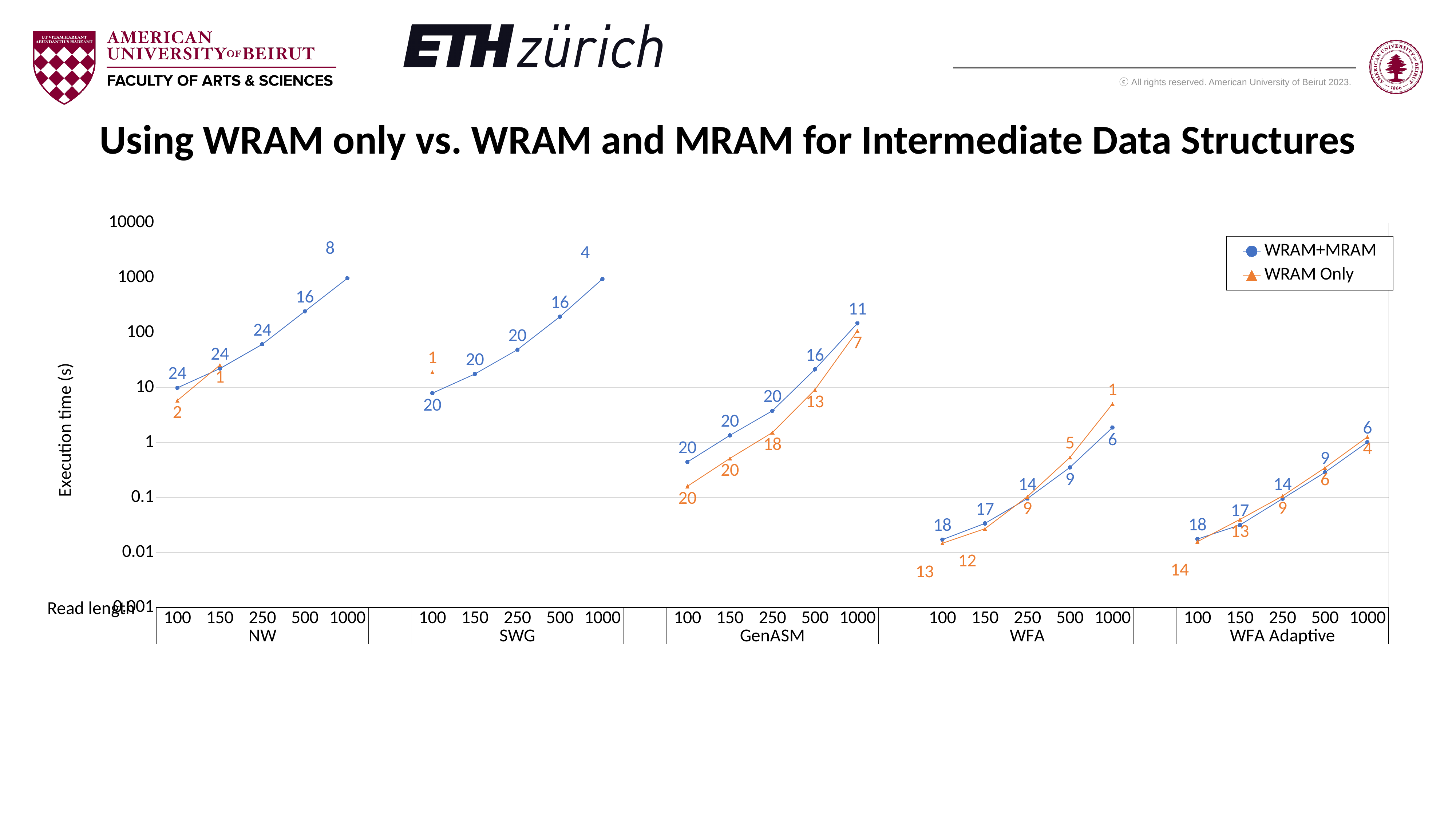
How many algorithm groups are shown along the x axis? 5 What is the label of the y axis? Execution time (s) Is the WRAM+MRAM execution time for NW at read length 500 greater or less than 100? greater How many series does the legend list? 2 Is the WRAM+MRAM execution time for GenASM at read length 1000 greater or less than 100? greater Is the WRAM+MRAM execution time for SWG at read length 100 greater or less than 10? less What kind of chart is shown on the slide? line chart Within each algorithm group, does execution time rise or fall as read length increases from 100 to 1000? rise For GenASM at read length 100, which series has the higher execution time, WRAM+MRAM or WRAM Only? WRAM+MRAM How many read lengths are plotted for each algorithm group? 5 For WFA at read length 1000, which series has the higher execution time, WRAM+MRAM or WRAM Only? WRAM Only What are the two series named in the legend? WRAM+MRAM and WRAM Only